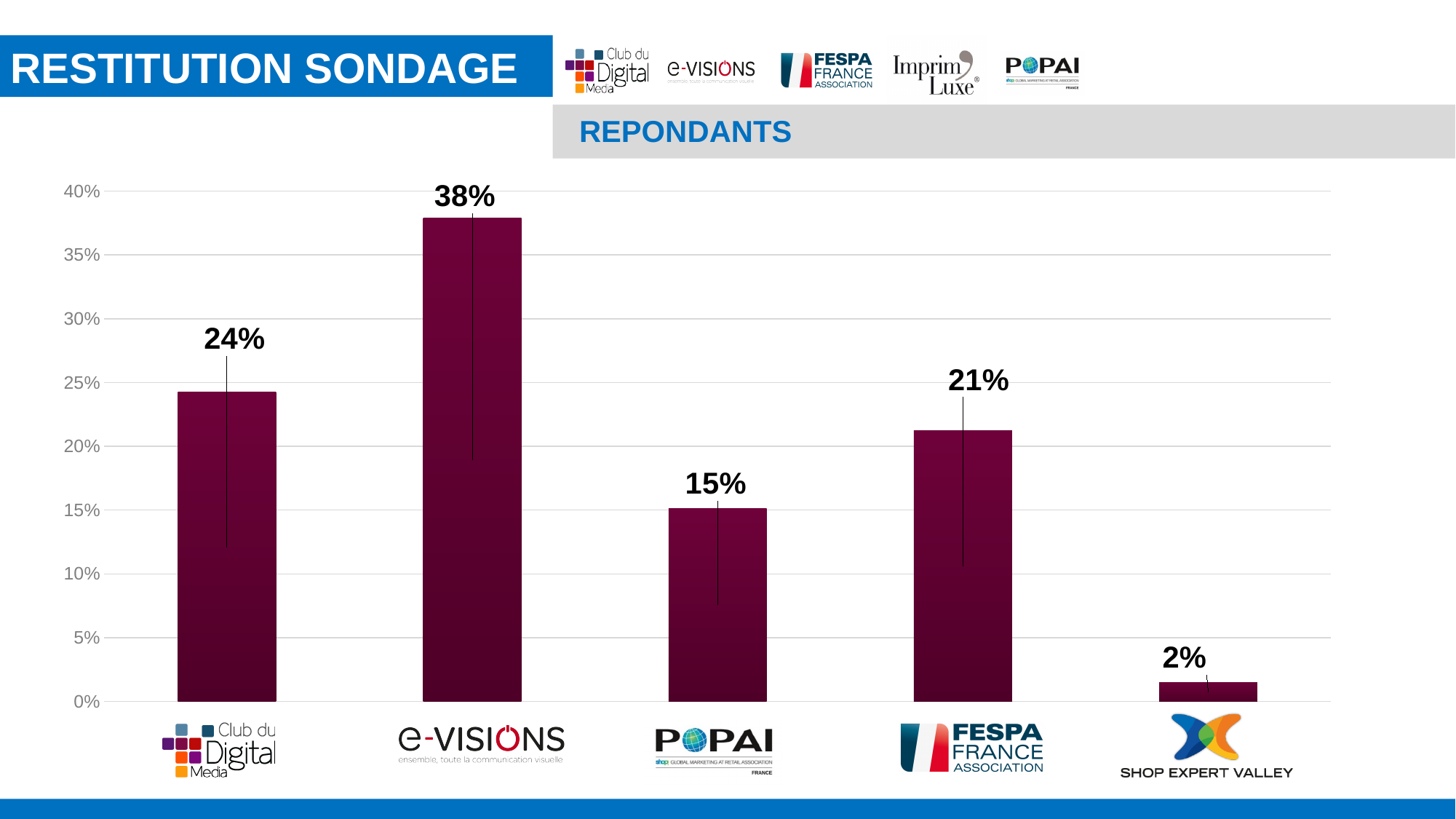
What kind of chart is shown on the slide? Bar chart What percentage of respondents does the chart show for Club du Digital Media? 24% What is the title shown above the chart? REPONDANTS Which organisation has the lowest share of respondents? Shop Expert Valley What percentage of respondents does the chart show for FESPA France Association? 21% What is the difference in percentage points between e-VISIONS and Club du Digital Media? 14 What percentage of respondents does the chart show for Shop Expert Valley? 2% Which organisation has the highest share of respondents? e-VISIONS What percentage of respondents does the chart show for POPAI? 15% Which has a larger share of respondents, FESPA France Association or POPAI? FESPA France Association How many organisations (bars) are shown in the chart? 5 What percentage of respondents does the chart show for e-VISIONS? 38%